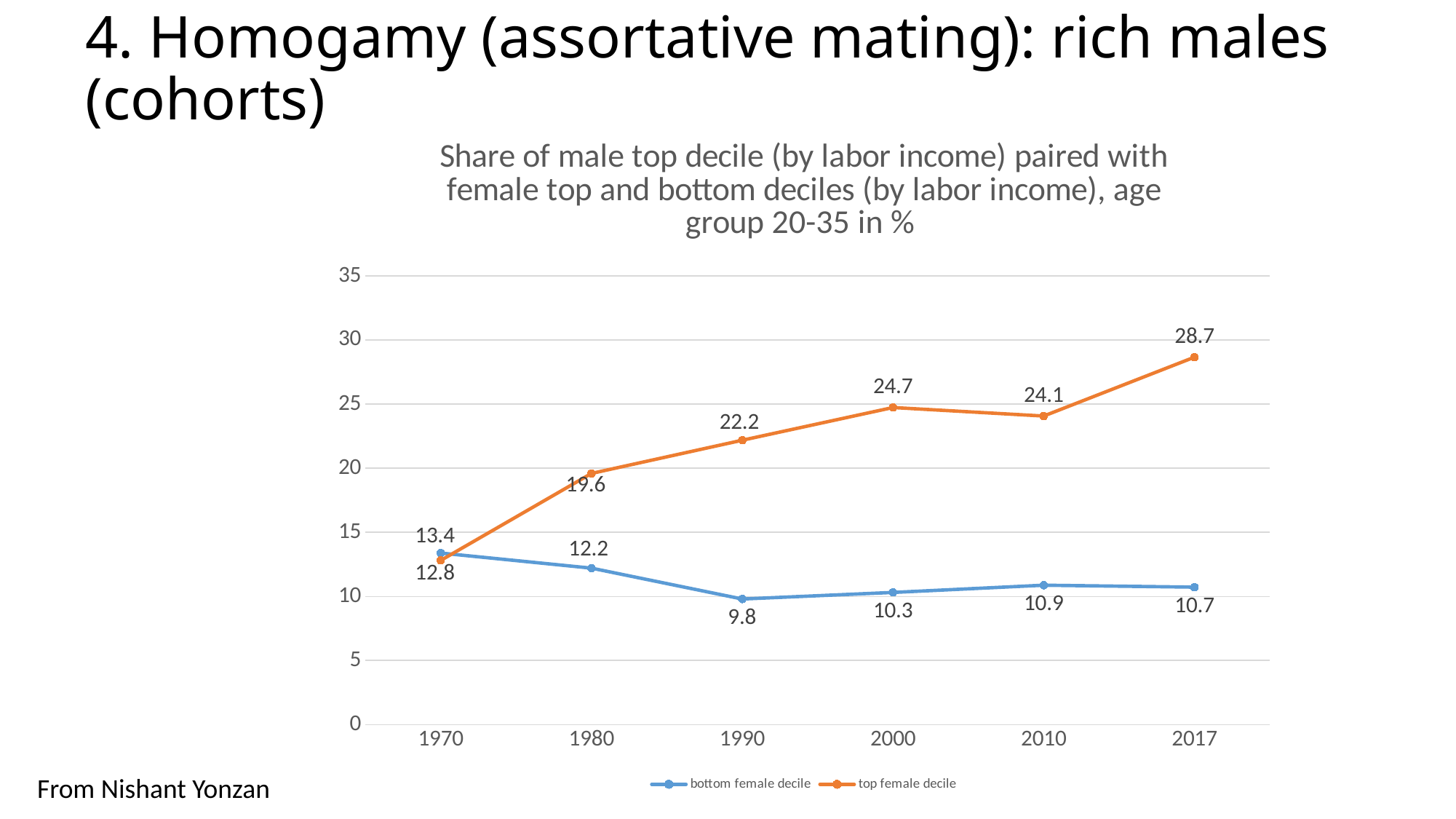
How many series does the legend list? 2 Is the value for the top female decile in 2010 greater or less than 20? greater What kind of chart is shown on the slide? line chart How many years are shown on the x axis? 6 Which series has the larger value in 1970, bottom female decile or top female decile? bottom female decile What is the value for the top female decile in 2017? 28.7 What is the value for the bottom female decile in 1990? 9.8 Does the top female decile series generally rise or fall from 1970 to 2017? rise What is the difference between the top female decile and bottom female decile values in 2000? 14.4 What is the value for the top female decile in 1970? 12.8 In which year is the top female decile series highest? 2017 In which year is the bottom female decile series lowest? 1990